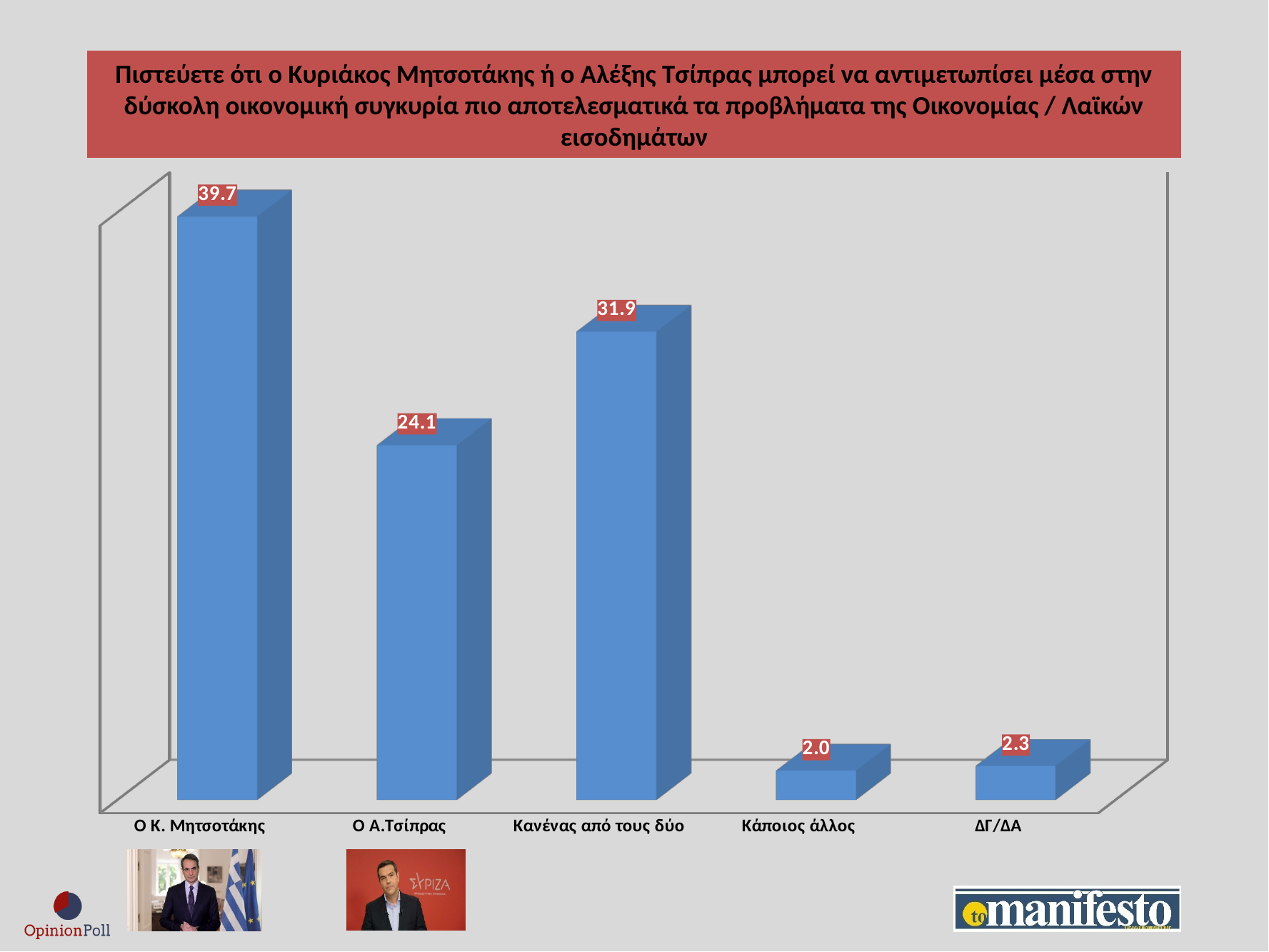
What is the value for Κανένας από τους δύο? 31.9 What kind of chart is shown on the slide? Bar chart What is the difference between the values for Ο Κ. Μητσοτάκης and Ο Α.Τσίπρας? 15.6 Which category has the lowest value? Κάποιος άλλος Which category has the highest value? Ο Κ. Μητσοτάκης How many categories are shown on the chart? 5 What is the value for Κάποιος άλλος? 2.0 What is the difference between the values for Κανένας από τους δύο and Ο Α.Τσίπρας? 7.8 What is the value for Ο Κ. Μητσοτάκης? 39.7 Which is larger, the value for Ο Α.Τσίπρας or the value for Κανένας από τους δύο? Κανένας από τους δύο What is the value for Ο Α.Τσίπρας? 24.1 What is the value for ΔΓ/ΔΑ? 2.3